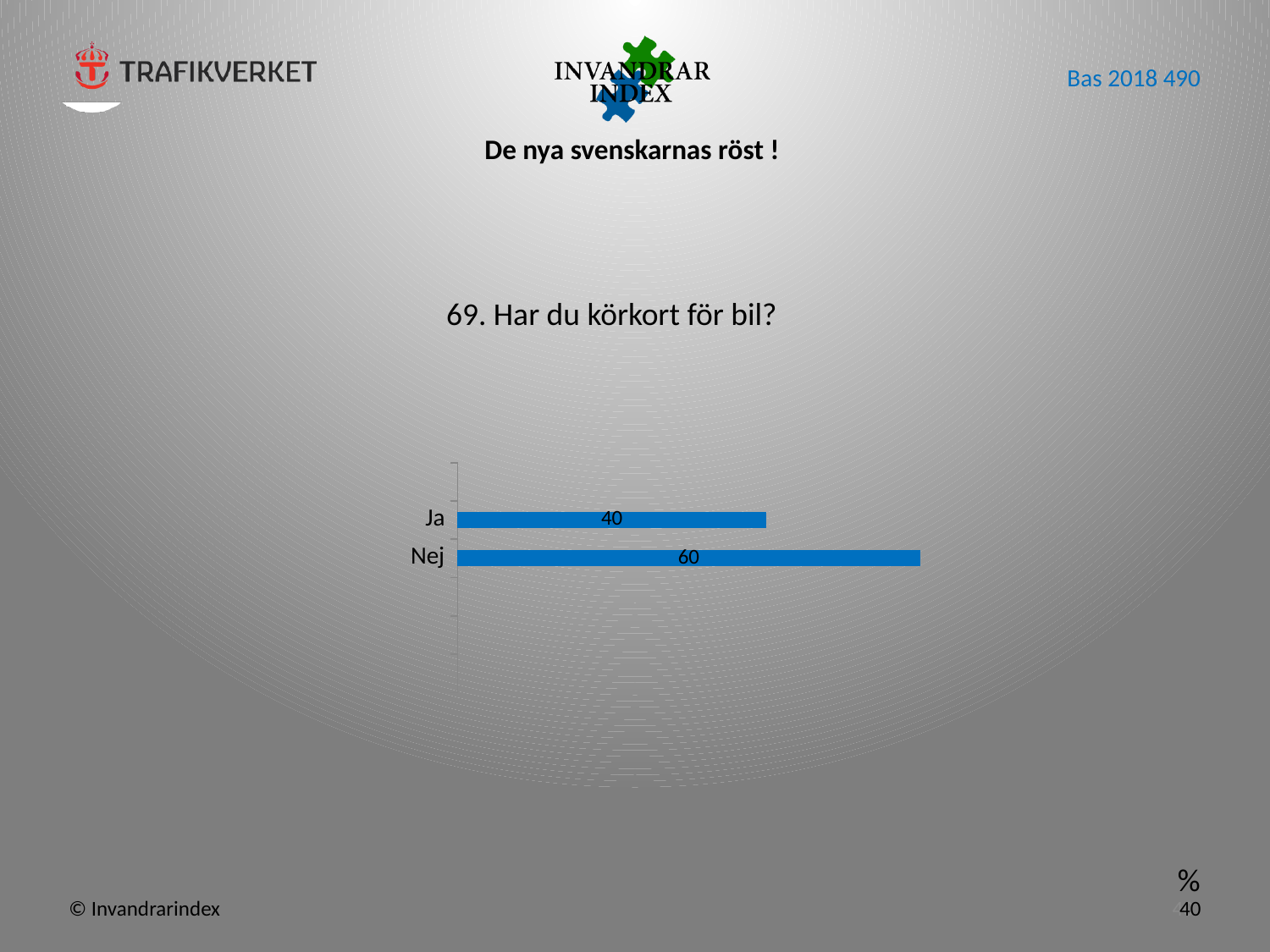
Which category has the lowest value? Ja What is the value for Nej? 60 Which category has the highest value? Nej How many categories are shown in the chart? 2 What colour are the bars in the chart? Blue Which is larger, the value for Ja or the value for Nej? Nej What is the total of the values for Ja and Nej? 100 What is the difference between the values for Nej and Ja? 20 What question does the chart title ask? 69. Har du körkort för bil? What kind of chart is shown on the slide? Bar chart What is the value for Ja? 40